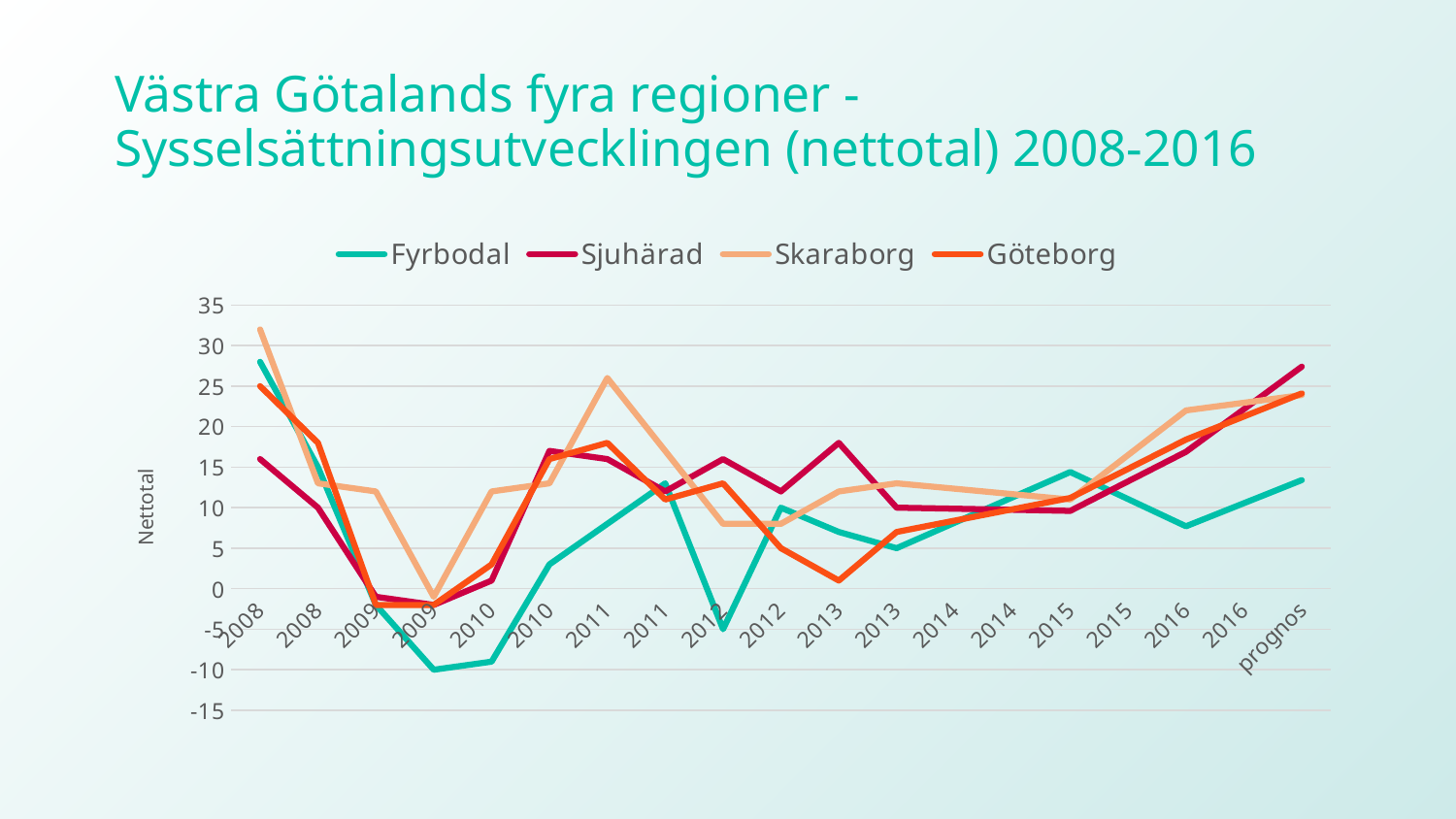
Which region has the lowest value at the second 2009 point? Fyrbodal How many points are there along the x axis? 19 Is the value for Skaraborg at the first 2008 point greater or less than 30? greater What is the label on the y axis? Nettotal Is the value for Fyrbodal at the second 2009 point greater or less than -5? less Does the Sjuhärad line rise or fall from the second 2015 point to the prognos point? rise What kind of chart is shown on the slide? line chart Which region has the highest value at the prognos point? Sjuhärad How many series does the legend list? 4 At the first 2011 point, which is larger: Skaraborg or Fyrbodal? Skaraborg Which region has the highest value at the first 2008 point? Skaraborg Is the value for Göteborg at the first 2013 point greater or less than 5? less